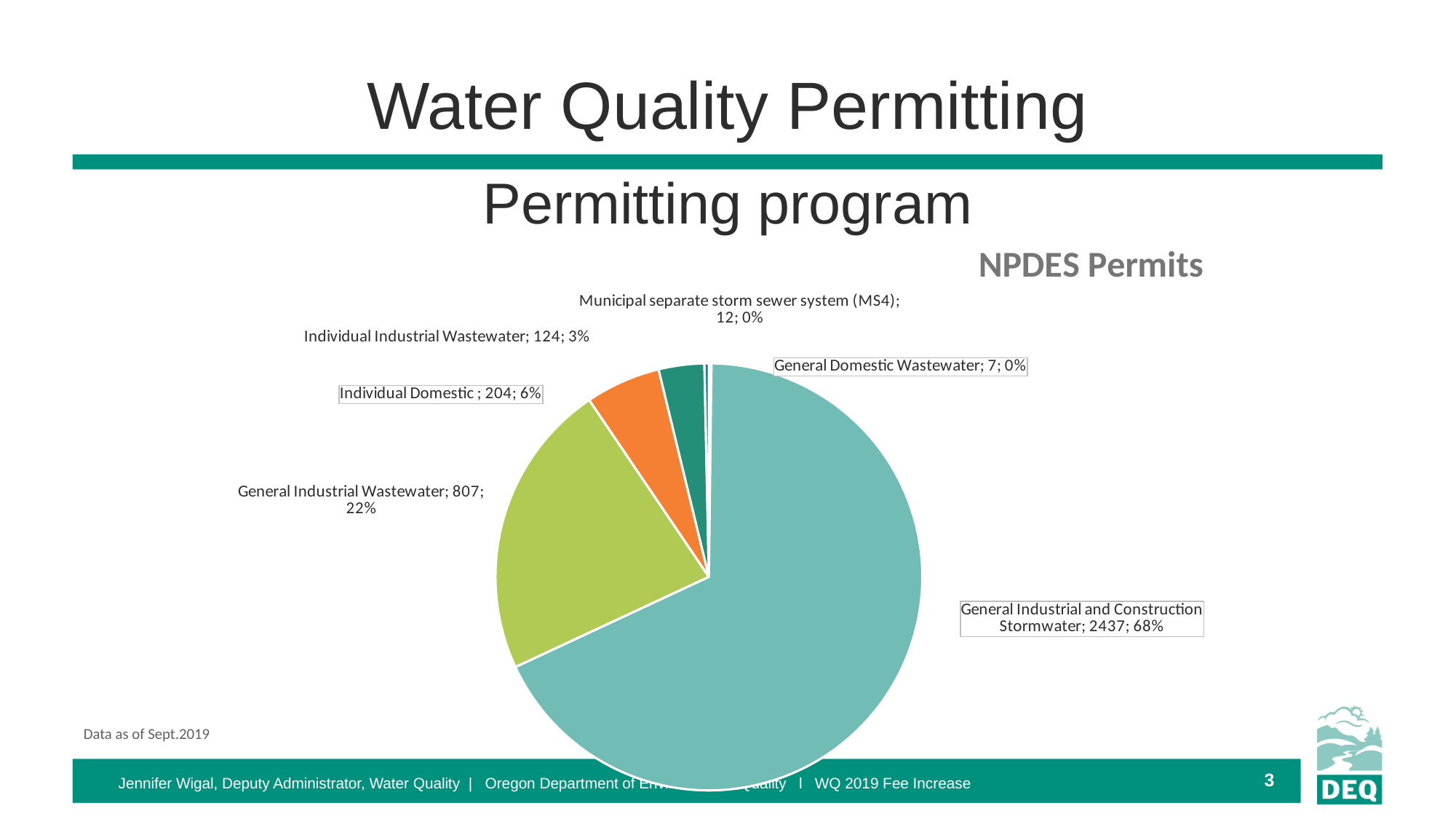
How many Individual Domestic permits are shown? 204 What is the difference between the number of General Industrial Wastewater permits and Individual Domestic permits? 603 How many Municipal separate storm sewer system (MS4) permits are shown? 12 What share of the pie does General Industrial Wastewater represent? 22% Which category has the smallest slice of the pie? General Domestic Wastewater How many slices does the pie chart have? 6 How many General Industrial and Construction Stormwater permits are shown? 2437 What percentage is shown for Individual Industrial Wastewater? 3% Which has more permits, Individual Industrial Wastewater or Individual Domestic? Individual Domestic What kind of chart is shown on the slide? pie chart What is the title of the chart? NPDES Permits Which category has the largest slice of the pie? General Industrial and Construction Stormwater